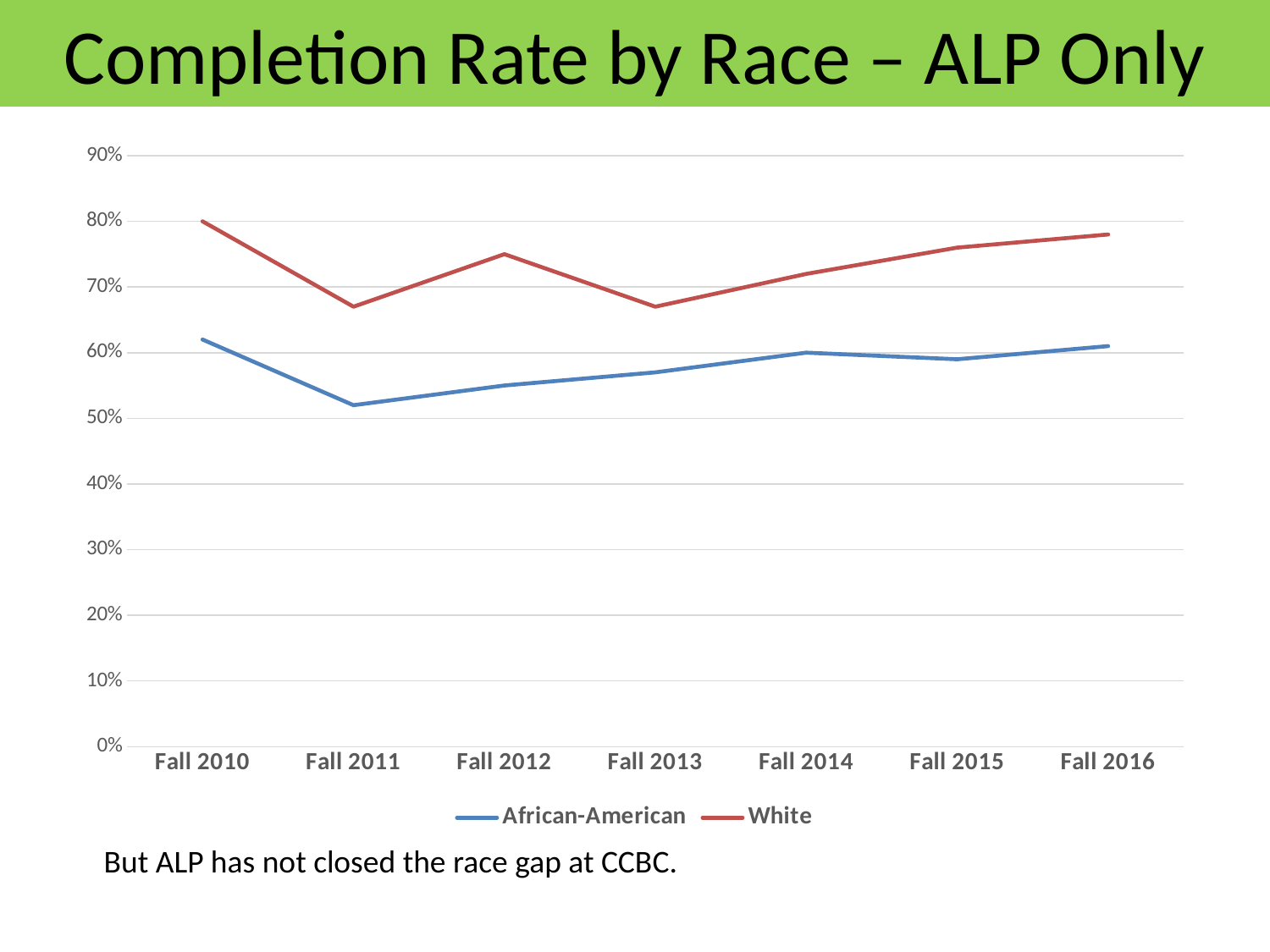
How many series does the legend list? 2 How many time points are plotted along the x axis? 7 What is the completion rate for White students in Fall 2010? 80% Is the African-American completion rate in Fall 2011 greater or less than 60%? less In which term is the White completion rate highest? Fall 2010 Is the White completion rate in Fall 2016 greater or less than 70%? greater Does the White completion rate rise or fall from Fall 2013 to Fall 2016? rise What is the completion rate for African-American students in Fall 2014? 60% Which colour is used for the White series line? Red In which term is the African-American completion rate lowest? Fall 2011 Which series has the higher completion rate in Fall 2013, African-American or White? White What type of chart is shown on the slide? Line chart